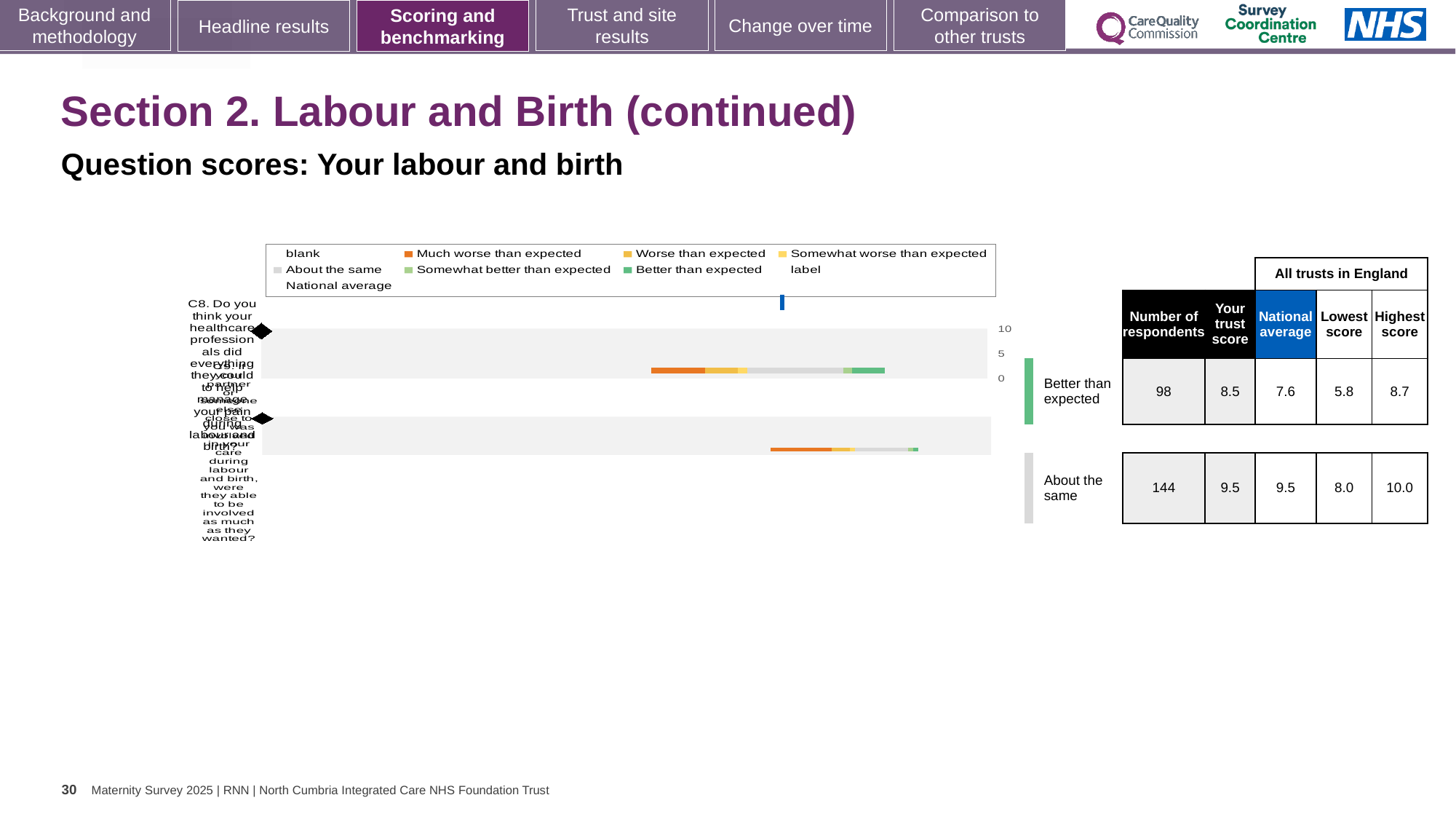
What is the difference in number of respondents between the 'About the same' row and the 'Better than expected' row? 46 How many question bars are plotted in the chart? 2 In the table, what is the highest score for the row labelled 'About the same'? 10.0 For the row labelled 'Better than expected', which is larger: the trust score or the national average? trust score What colour does the legend use for 'Much worse than expected'? orange Which row in the table has the higher number of respondents? About the same In the table, what is the number of respondents for the row labelled 'Better than expected'? 98 In the table, what is the national average for the row labelled 'Better than expected'? 7.6 For the row labelled 'Better than expected', what is the difference between the trust score and the national average? 0.9 In the table, what is the lowest score for the row labelled 'Better than expected'? 5.8 What kind of chart is shown on the slide? bar chart In the table, what is the trust score for the row labelled 'About the same'? 9.5